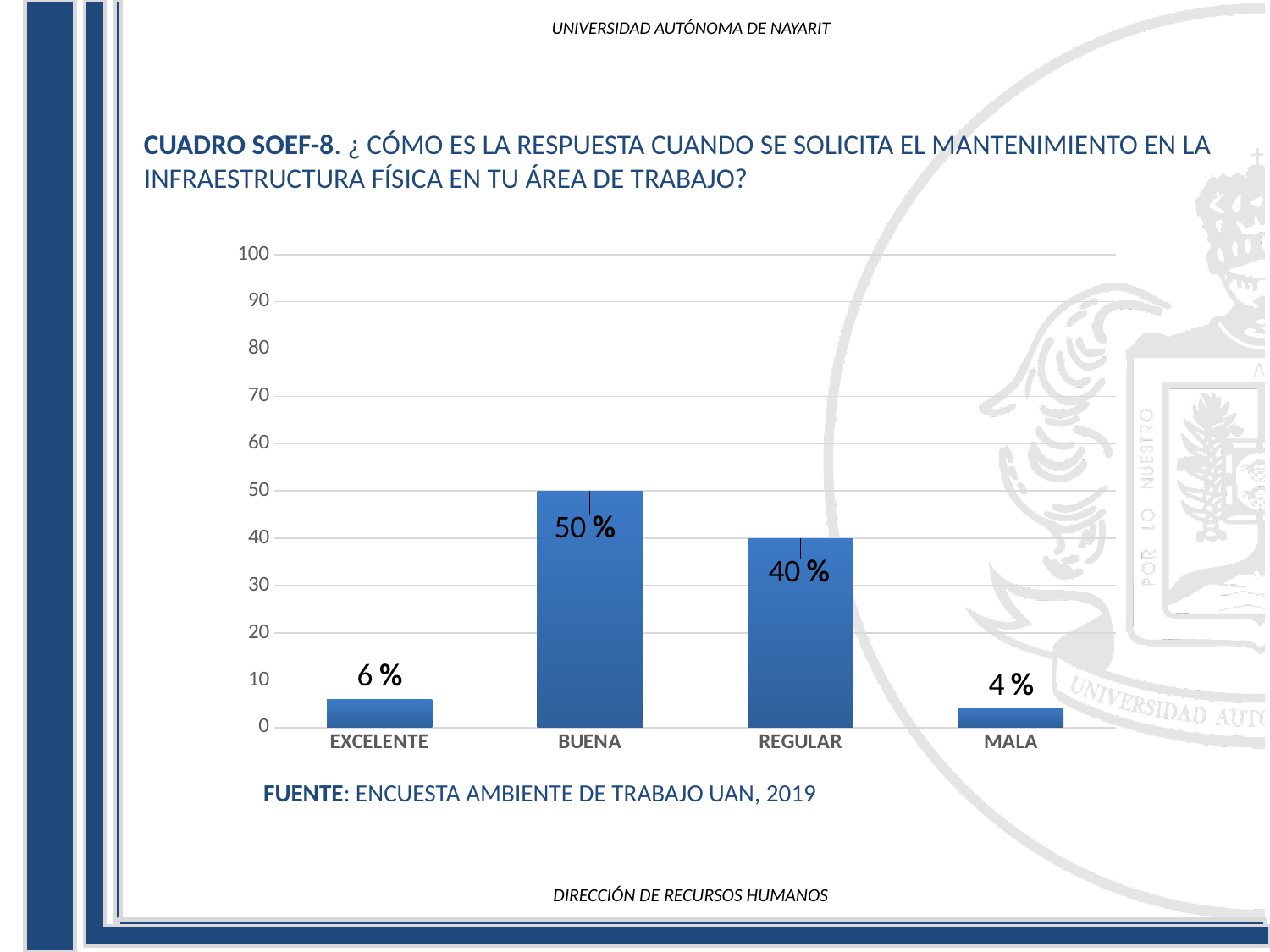
What is the value for EXCELENTE? 6 % Is the value for REGULAR greater or less than 30? greater Which is larger, the value for EXCELENTE or the value for MALA? EXCELENTE What is the value for BUENA? 50 % What kind of chart is shown on the slide? bar chart Which category has the highest value? BUENA What is the value for MALA? 4 % How many categories are shown on the x axis? 4 What is the value for REGULAR? 40 % What is the difference between the values for BUENA and REGULAR? 10 % Which category has the lowest value? MALA What source is cited below the chart? ENCUESTA AMBIENTE DE TRABAJO UAN, 2019